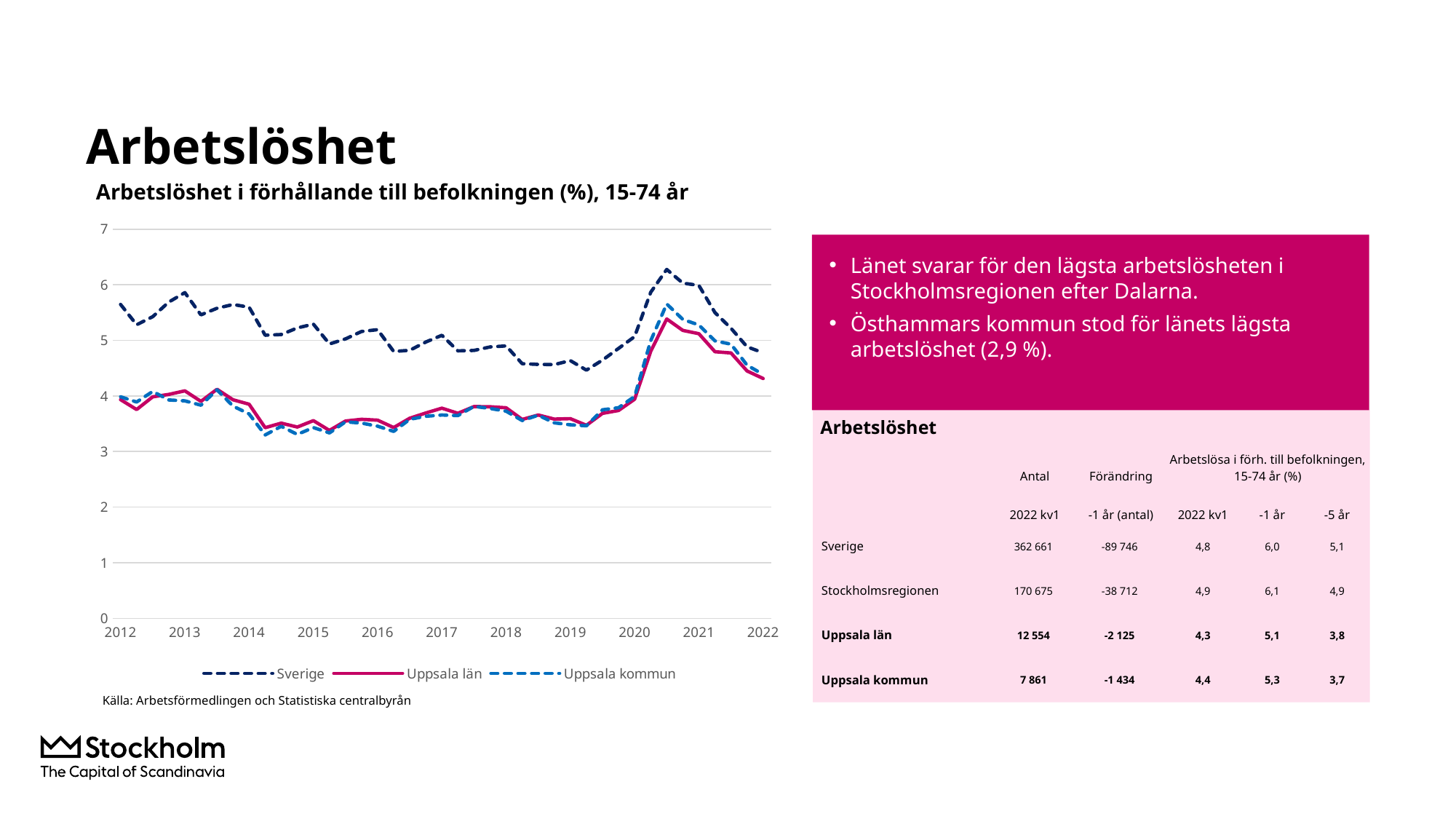
Is the peak value for Sverige around 2020 greater or less than 6? greater In 2012, which series has the higher value, Sverige or Uppsala län? Sverige What is the title of the chart? Arbetslöshet i förhållande till befolkningen (%), 15-74 år Does the Sverige line rise or fall between 2019 and 2020? rise What kind of chart is shown on the slide? line chart How many series does the chart legend list? 3 Is the value for Uppsala län in 2016 greater or less than 4? less What source is cited below the chart? Arbetsförmedlingen och Statistiska centralbyrån Which series has the highest values across the whole period shown in the chart? Sverige How many year labels are shown on the x axis of the chart? 11 Is the value for Sverige in 2012 greater or less than 5? greater